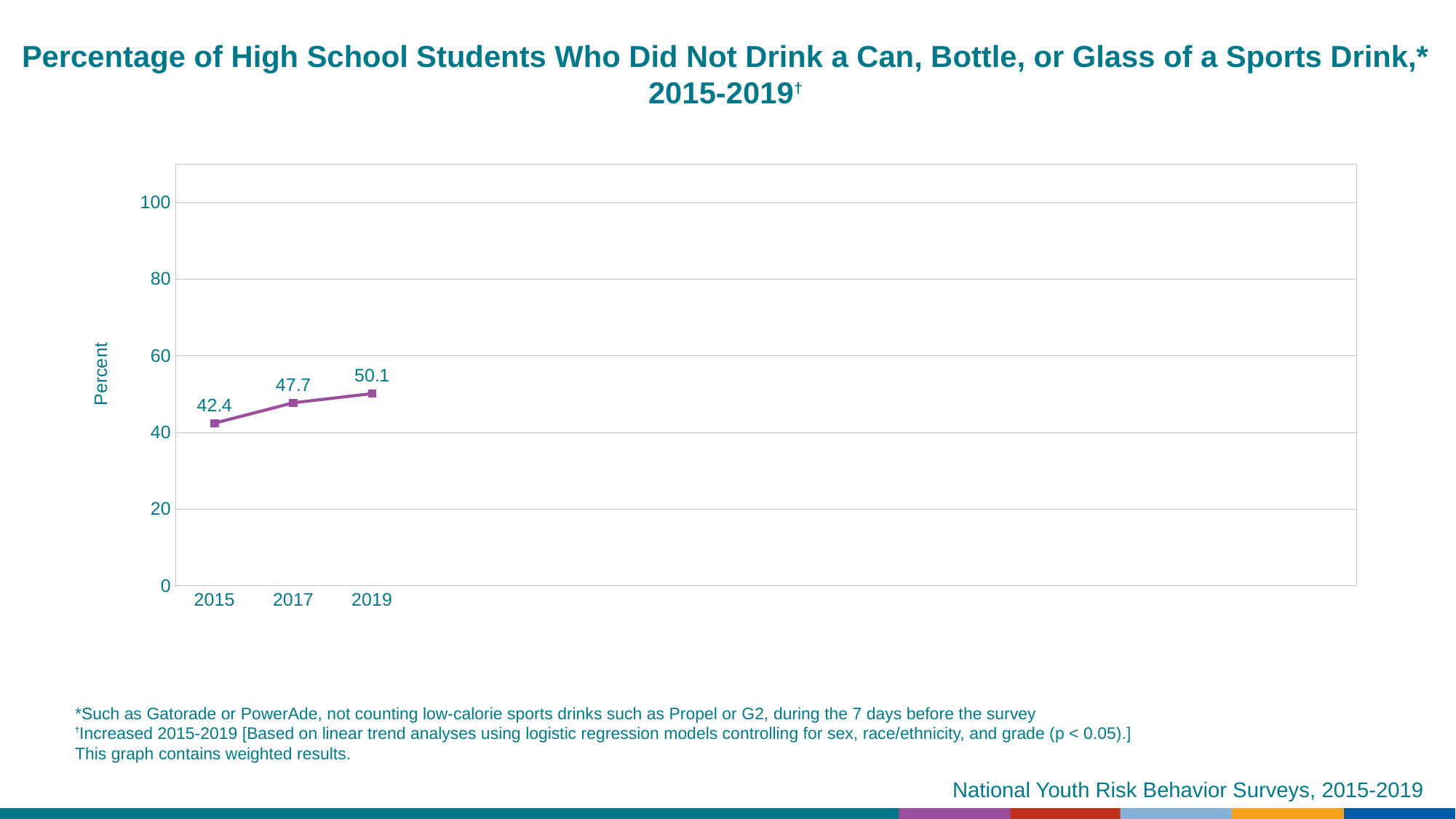
Which is larger, the value for 2017 or the value for 2019? 2019 Is the value for 2015 greater or less than 60? less What is the difference between the values for 2017 and 2015? 5.3 How many data points are plotted on the chart? 3 What is the difference between the values for 2019 and 2015? 7.7 What is the value for 2019? 50.1 Do the values rise or fall from 2015 to 2019? rise Which year has the highest value? 2019 What kind of chart is shown on the slide? line chart What is the value for 2017? 47.7 What is the value for 2015? 42.4 Which year has the lowest value? 2015